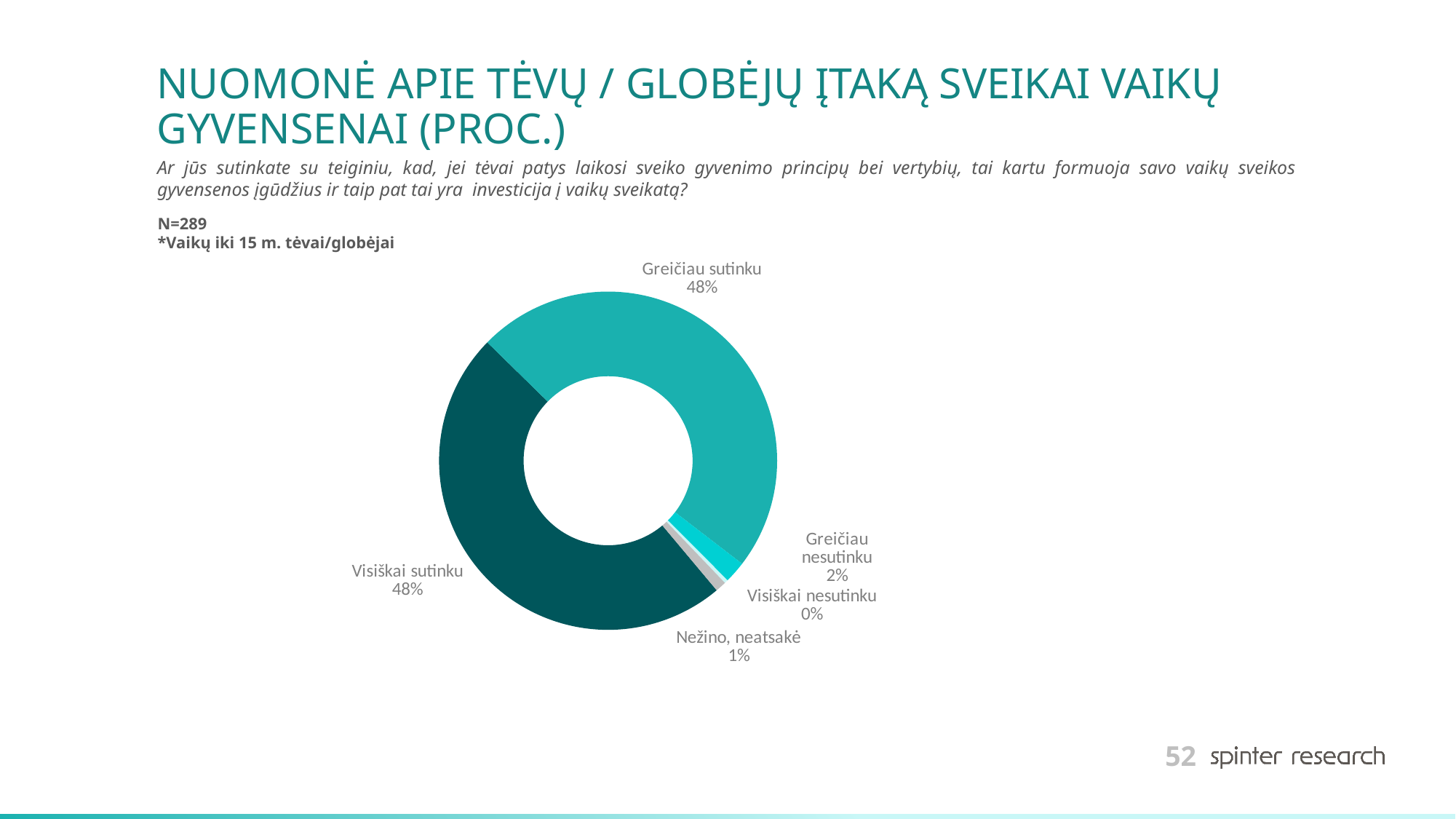
What share is shown for "Nežino, neatsakė"? 1% What share is shown for "Greičiau nesutinku"? 2% What type of chart is shown on the slide? Pie chart (doughnut) What is the difference in percentage points between "Visiškai sutinku" and "Greičiau nesutinku"? 46 Which is larger: the share for "Greičiau nesutinku" or for "Nežino, neatsakė"? Greičiau nesutinku How many categories are shown in the chart? 5 What is the sample size (N) stated on the slide? N=289 What share is shown for "Visiškai nesutinku"? 0% Do the shares for "Greičiau sutinku" and "Visiškai sutinku" have the same value? Yes, both 48% What percentage of respondents answered "Visiškai sutinku"? 48% What percentage of respondents answered "Greičiau sutinku"? 48% Which category has the smallest share in the chart? Visiškai nesutinku